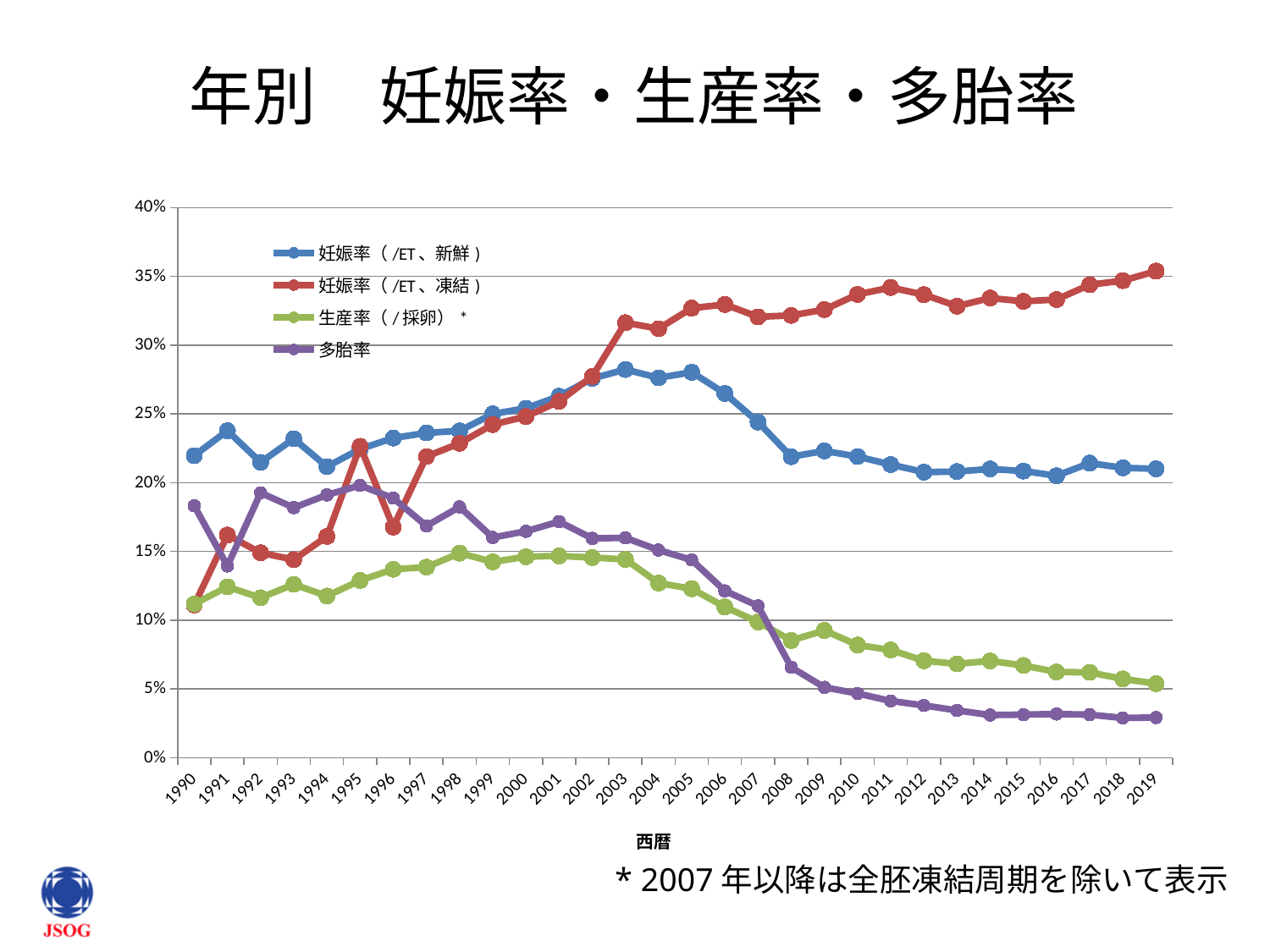
Which series has the lowest value in 2019? 多胎率 How many years are plotted along the x axis? 30 Is the value for 妊娠率（/ET、凍結） in 2019 greater or less than 30%? greater Does 多胎率 rise or fall from 2005 to 2019? fall In 1990, which is higher: 多胎率 or 生産率（/採卵）? 多胎率 What is the label of the x axis? 西暦 Is the value for 多胎率 in 2019 greater or less than 5%? less How many series does the legend list? 4 Is the value for 妊娠率（/ET、新鮮） in 2003 greater or less than 25%? greater In 2019, which is higher: 妊娠率（/ET、凍結） or 妊娠率（/ET、新鮮）? 妊娠率（/ET、凍結） What kind of chart is shown on the slide? line chart